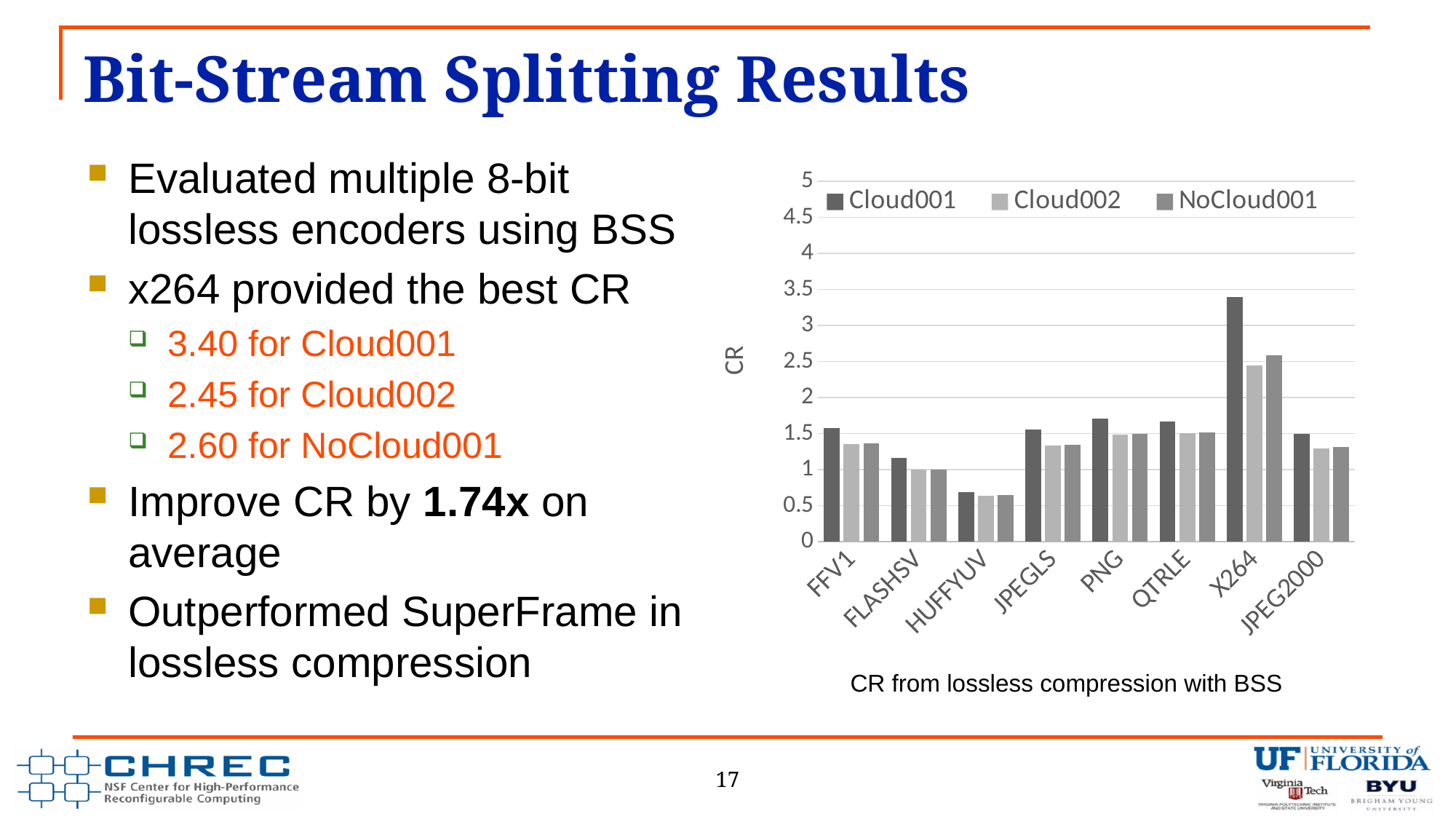
What is the label on the y axis of the chart? CR What is the CR for Cloud001 with x264, as stated on the slide? 3.40 For X264, which series has the larger CR: Cloud001 or NoCloud001? Cloud001 Which encoder has the lowest CR for Cloud001? HUFFYUV How many series does the chart legend list? 3 Is the Cloud001 value for HUFFYUV greater or less than 1? less How many encoders (categories) are shown on the x axis of the chart? 8 Which encoder has the highest CR for NoCloud001? X264 What kind of chart is shown on the slide? bar chart Is the Cloud001 value for X264 greater or less than 3? greater Is the Cloud002 value for JPEG2000 greater or less than 1.5? less Which encoder has the highest CR for Cloud001? X264